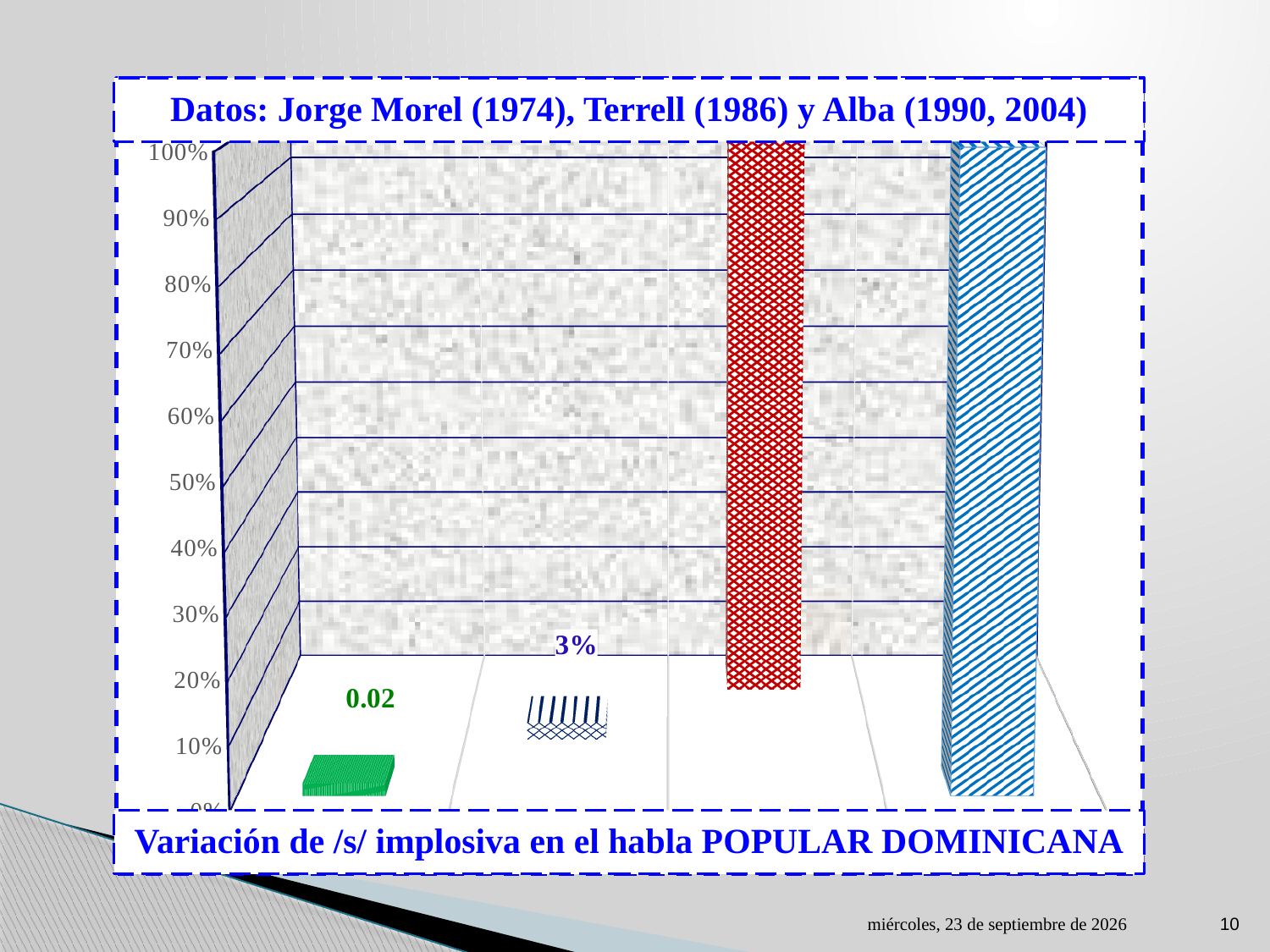
Is the value of the blue striped bar on the far right greater or less than 50%? greater Which is larger, the green bar on the far left or the hatched bar second from the left? the hatched bar second from the left What value is printed above the second bar from the left (the dark hatched bar)? 3% What kind of chart is shown on the slide? bar chart What value is printed above the green bar on the far left? 0.02 How many bars are plotted in the chart? 4 What is the highest value shown on the vertical axis? 100% Is the value of the green bar on the far left greater or less than 10%? less Which bar is the lowest in the chart? the green bar on the far left What is the title printed above the chart? Datos: Jorge Morel (1974), Terrell (1986) y Alba (1990, 2004)